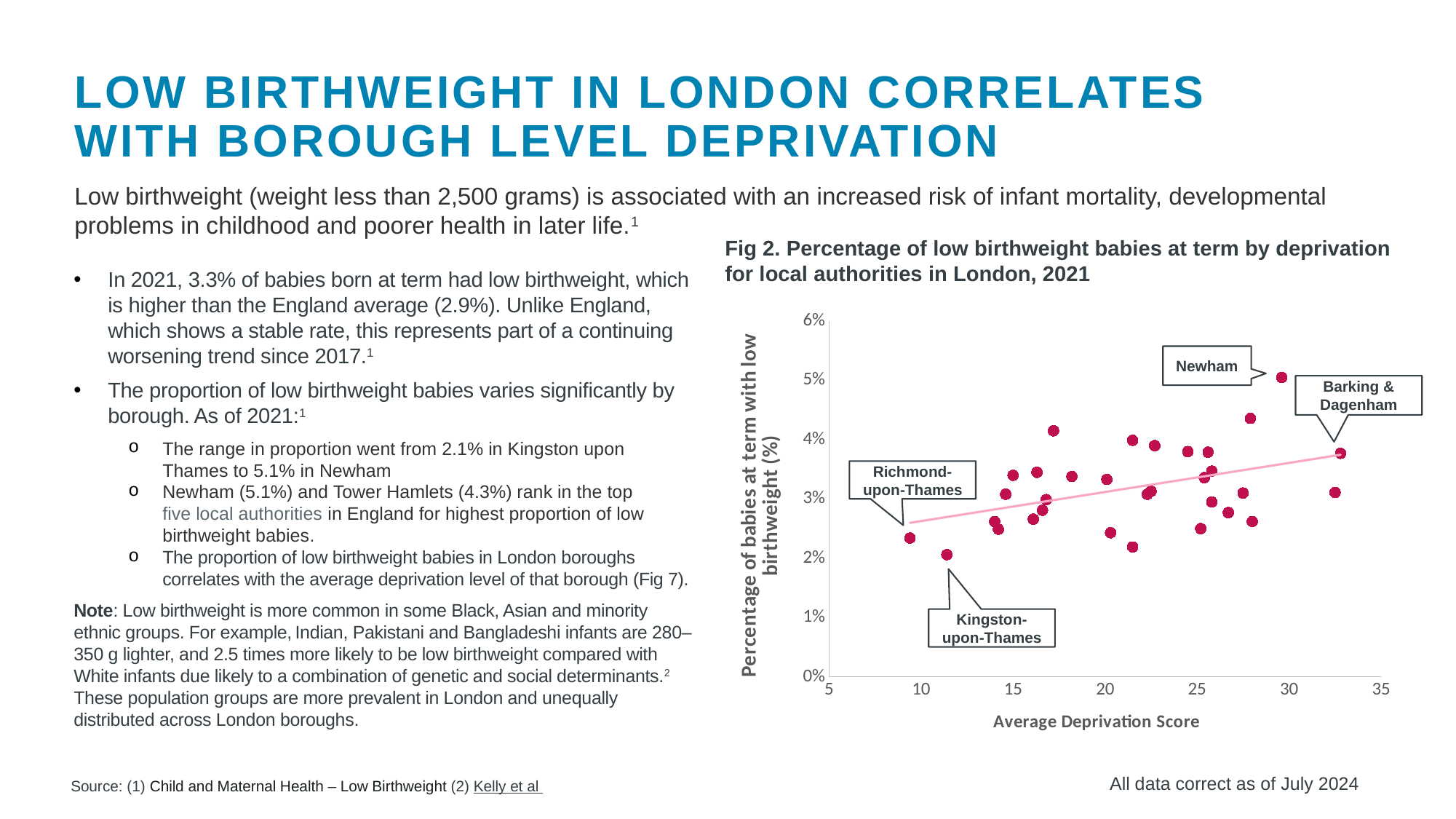
What kind of chart is Fig 2? scatter chart In Fig 2, which labelled local authority has the lowest percentage of low birthweight babies at term? Kingston-upon-Thames In Fig 2, is the percentage of low birthweight babies for Newham greater or less than 4%? greater In Fig 2, is the average deprivation score for Barking & Dagenham greater or less than 30? greater How many local authorities are labelled by name on the Fig 2 chart? 4 In Fig 2, is the percentage of low birthweight babies for Barking & Dagenham greater or less than 3%? greater In Fig 2, which labelled local authority has the highest percentage of low birthweight babies at term? Newham What is the x-axis title of the Fig 2 chart? Average Deprivation Score In Fig 2, does the trend line show the percentage of low birthweight babies rising or falling as the average deprivation score increases? rising In Fig 2, which has a higher percentage of low birthweight babies, Newham or Barking & Dagenham? Newham